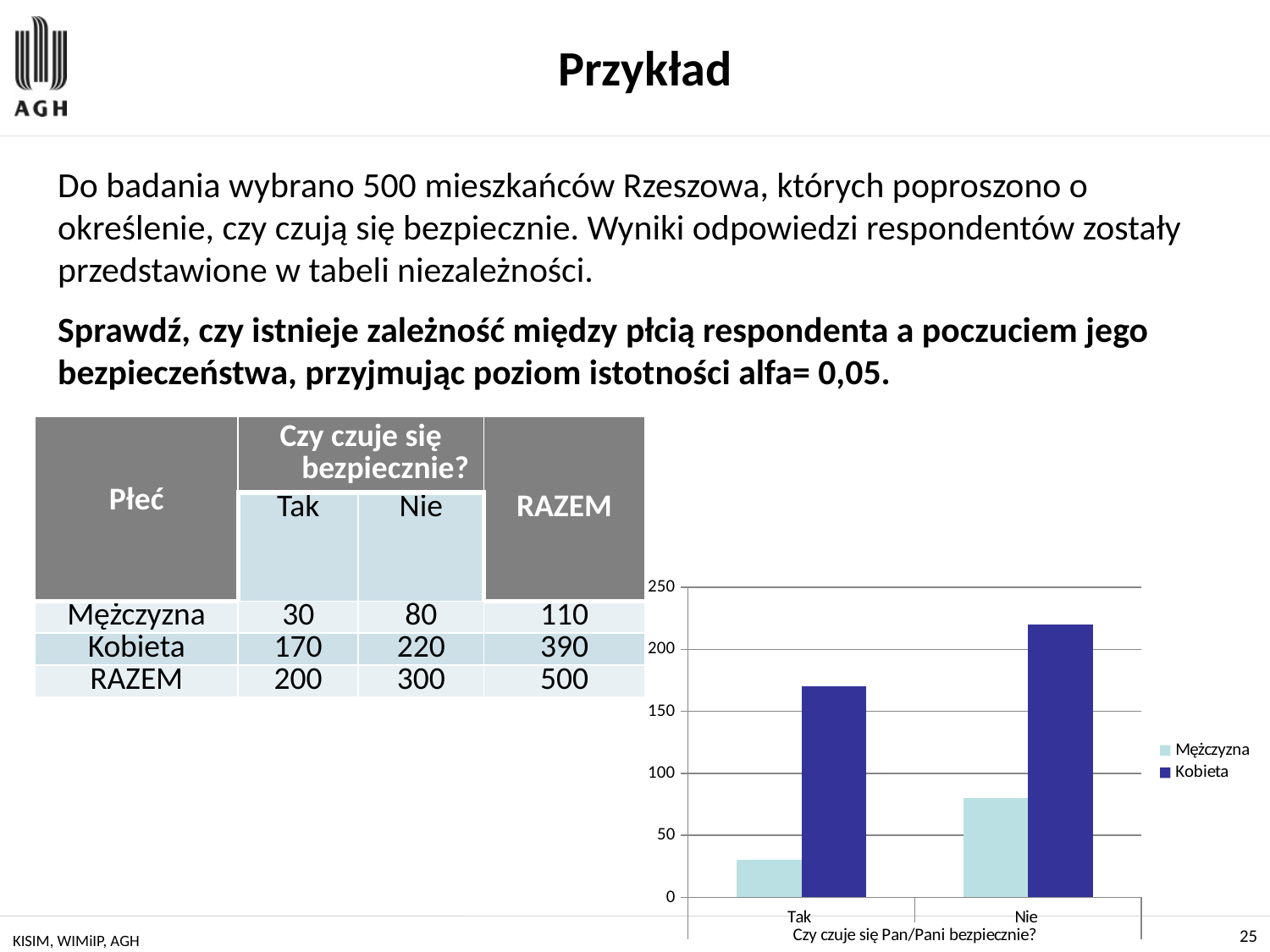
What is the x-axis title of the chart? Czy czuje się Pan/Pani bezpiecznie? Is the value of the Kobieta bar for Nie greater or less than 200? greater How many categories are shown on the x axis of the chart? 2 What is the difference between the Kobieta and Mężczyzna bars for the category Nie? 140 What is the value of the Kobieta bar for the category Tak? 170 What is the value of the Mężczyzna bar for the category Nie? 80 What is the value of the Kobieta bar for the category Nie? 220 Which category has the lowest bar in the chart? Tak (Mężczyzna) What kind of chart is shown on the slide? bar chart Is the value of the Mężczyzna bar for Tak greater or less than 50? less How many series does the chart legend list? 2 Which series has the higher bar for the category Tak, Mężczyzna or Kobieta? Kobieta